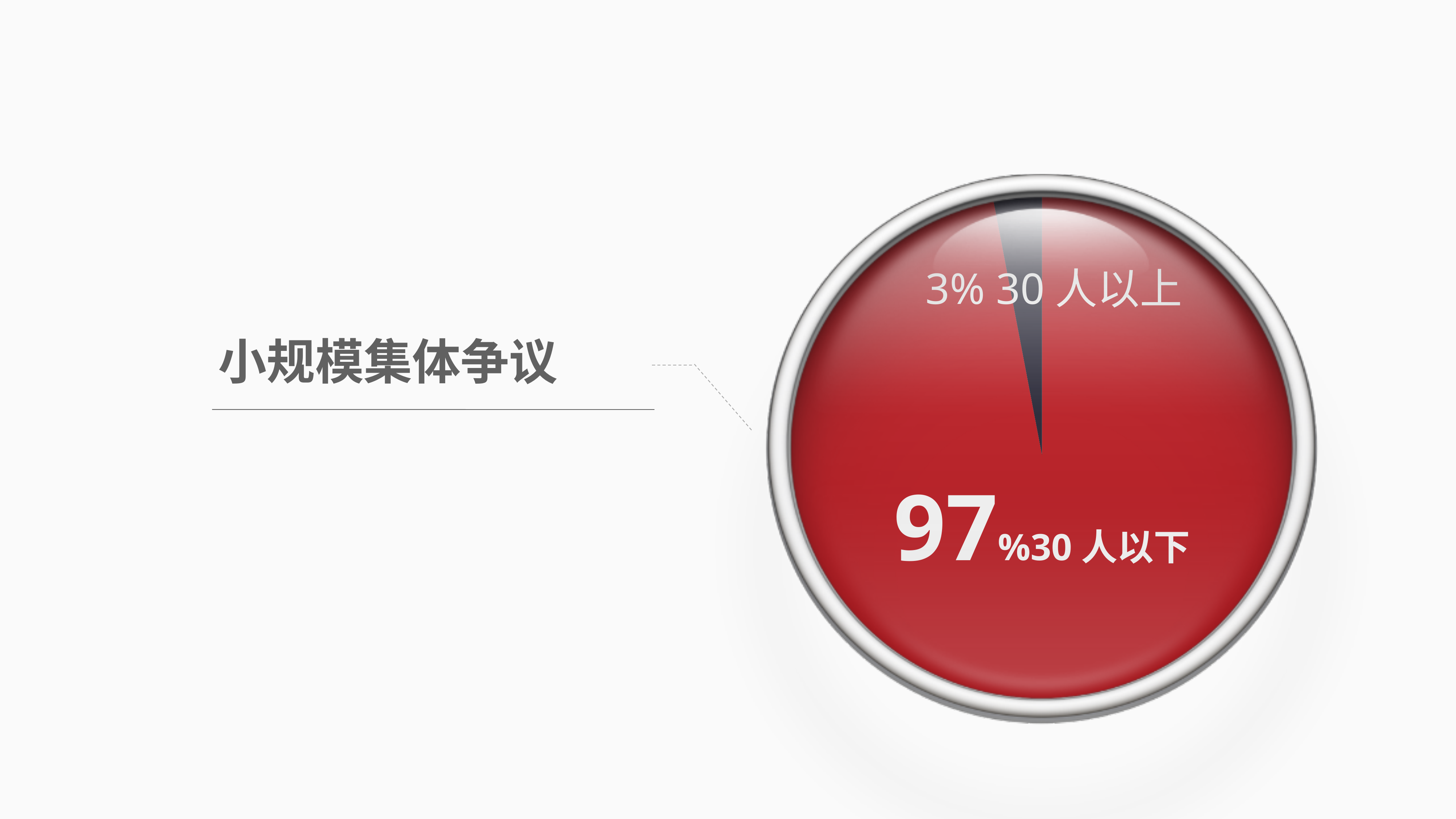
How many slices does the pie chart have? 2 What share of the pie does the "30 人以下" slice represent? 97% What share of the pie does the "30 人以上" slice represent? 3% What kind of chart is shown on the slide? pie chart Which is larger, the "30 人以上" slice or the "30 人以下" slice? 30 人以下 What colour is the "30 人以下" slice of the pie chart? red What is the total of the two percentages shown in the pie chart? 100% What is the title text shown to the left of the pie chart? 小规模集体争议 Which slice of the pie is the smallest? 30 人以上 Which slice of the pie is the largest? 30 人以下 What is the difference in percentage points between the "30 人以下" slice and the "30 人以上" slice? 94